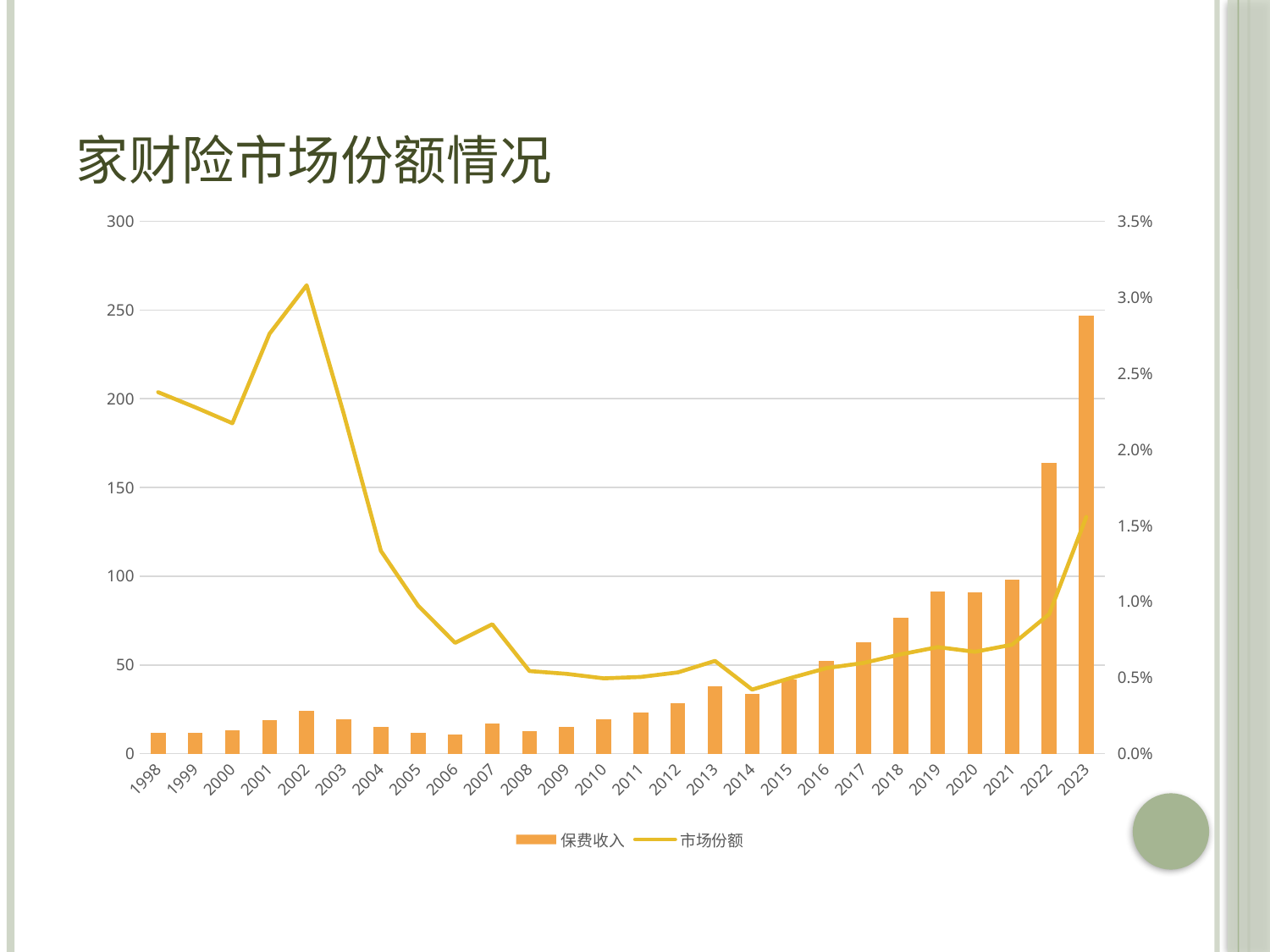
Is the 保费收入 value for 2019 greater or less than 100? less Is the 市场份额 value for 2002 greater or less than 2.5%? greater What kind of chart is shown on the slide? A combined bar and line chart Which is larger, the 保费收入 bar for 2021 or for 2022? 2022 Is the 市场份额 value for 2014 greater or less than 0.5%? less How many series does the legend list? 2 Which year has the highest 保费收入 bar? 2023 In which year does the 市场份额 line reach its highest point? 2002 Does the 市场份额 line rise or fall from 2002 to 2008? fall How many years are shown on the x axis? 26